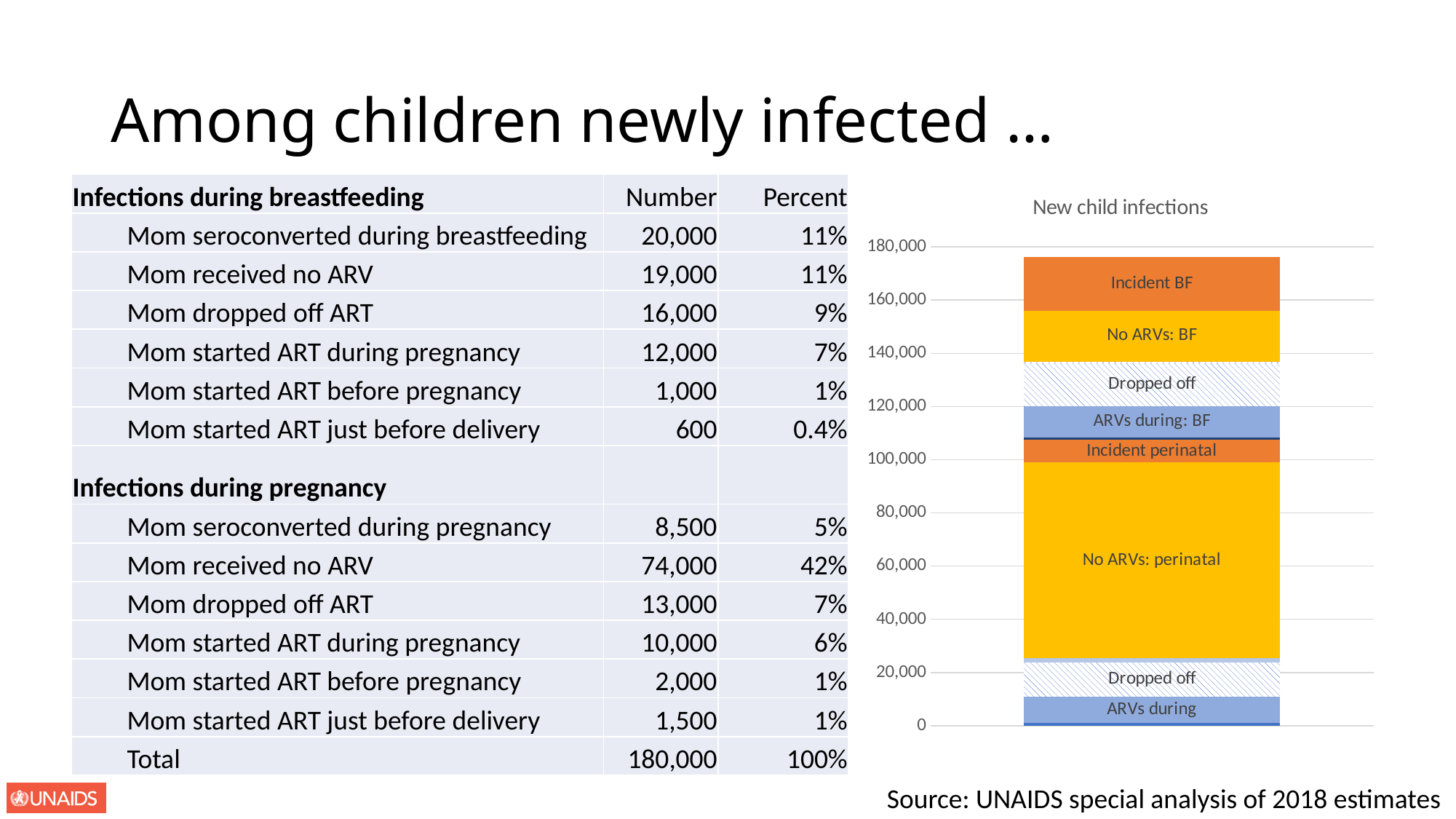
What is the title of the chart on the right of the slide? New child infections How many bars does the 'New child infections' chart contain? 1 In the 'New child infections' chart, which segment is the largest? No ARVs: perinatal In the 'New child infections' chart, which segment is larger: 'Incident BF' or 'Incident perinatal'? Incident BF In the 'New child infections' chart, which segment is larger: 'No ARVs: perinatal' or 'No ARVs: BF'? No ARVs: perinatal In the 'New child infections' chart, is the top of the 'Incident perinatal' segment greater or less than 100,000? greater What kind of chart is shown on the right of the slide? stacked bar chart In the 'New child infections' chart, is the top of the 'ARVs during' segment at the bottom of the bar greater or less than 20,000? less In the 'New child infections' chart, is the top of the stacked bar greater or less than 160,000? greater What is the highest value shown on the vertical axis of the 'New child infections' chart? 180,000